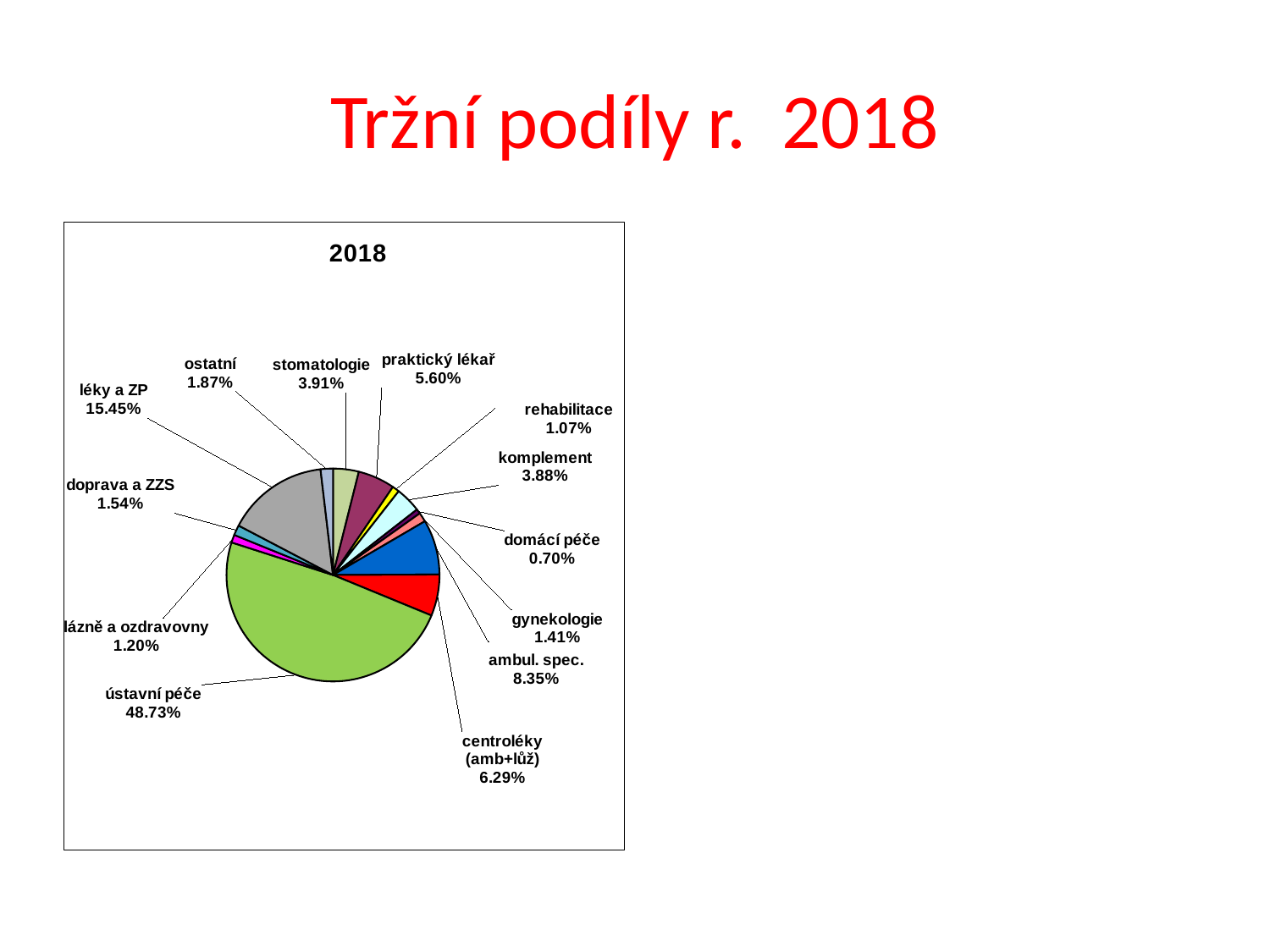
How many slices does the pie chart have? 13 What type of chart is shown on the slide? pie chart What is the share for centroléky (amb+lůž)? 6.29% What is the share for ústavní péče? 48.73% What is the difference in share between stomatologie and komplement? 0.03% Which category has the largest share of the pie? ústavní péče What is the title shown inside the chart area? 2018 Which has a larger share, ambul. spec. or praktický lékař? ambul. spec. What is the share for domácí péče? 0.70% What is the difference in share between léky a ZP and ambul. spec.? 7.10% Which category has the smallest share of the pie? domácí péče What is the share for léky a ZP? 15.45%